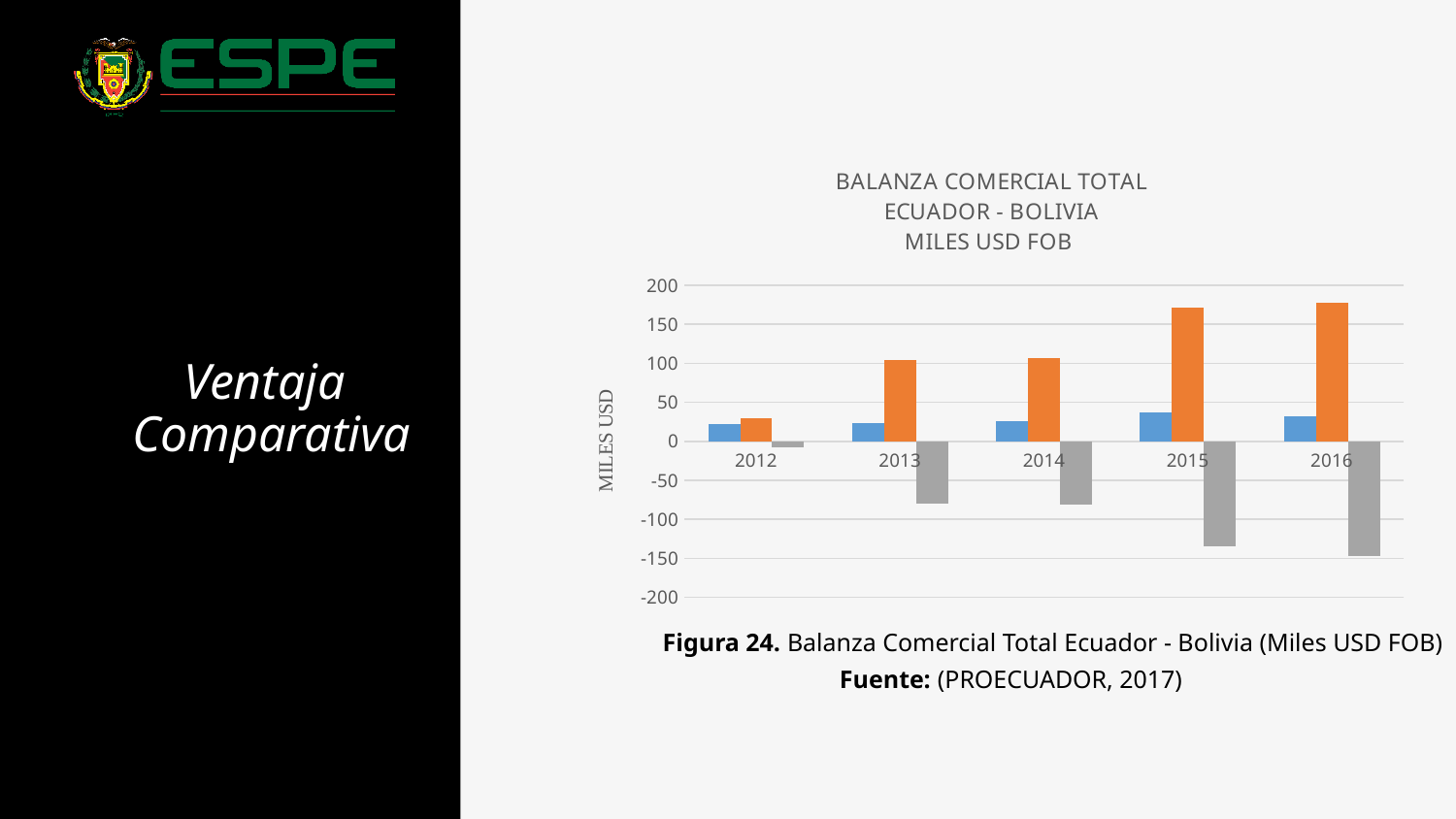
Is the value of the orange bar for 2015 greater or less than 150? greater How many years are shown on the x axis of the chart? 5 Is the value of the blue bar for 2015 greater or less than 50? less Is the value of the orange bar for 2013 greater or less than 50? greater Do the orange bars generally rise or fall from 2012 to 2016? rise In which year is the orange bar the lowest? 2012 What is the label on the vertical axis of the chart? MILES USD How many bars are plotted for each year in the chart? 3 What is the title of the chart? BALANZA COMERCIAL TOTAL ECUADOR - BOLIVIA MILES USD FOB What kind of chart is shown on the slide? bar chart